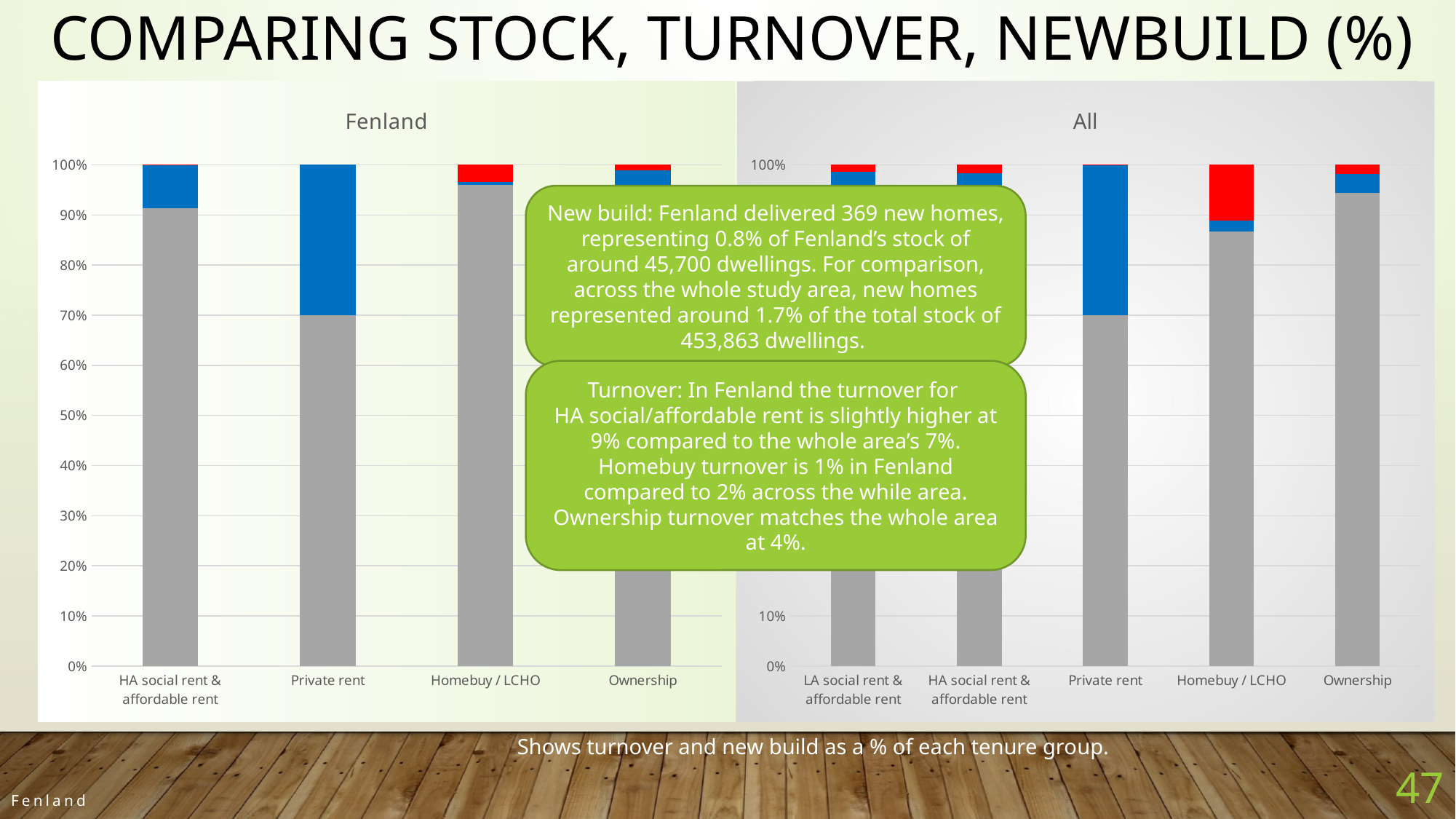
In the Fenland chart, which has the larger grey segment: HA social rent & affordable rent or Private rent? HA social rent & affordable rent In the All chart, which category has the largest red segment? Homebuy / LCHO How many tenure categories are shown on the x axis of the Fenland chart? 4 In the Fenland chart, is the grey segment for Private rent greater or less than 80%? less In the All chart, is the grey segment for Private rent greater or less than 60%? greater In the Fenland chart, is the grey segment for Homebuy / LCHO greater or less than 90%? greater In the Fenland chart, which category has the smallest grey segment? Private rent What is the title of the chart on the right side of the slide? All What kind of chart is the Fenland chart? stacked bar chart How many tenure categories are shown on the x axis of the All chart? 5 What colour is the bottom segment of each bar in both charts? grey